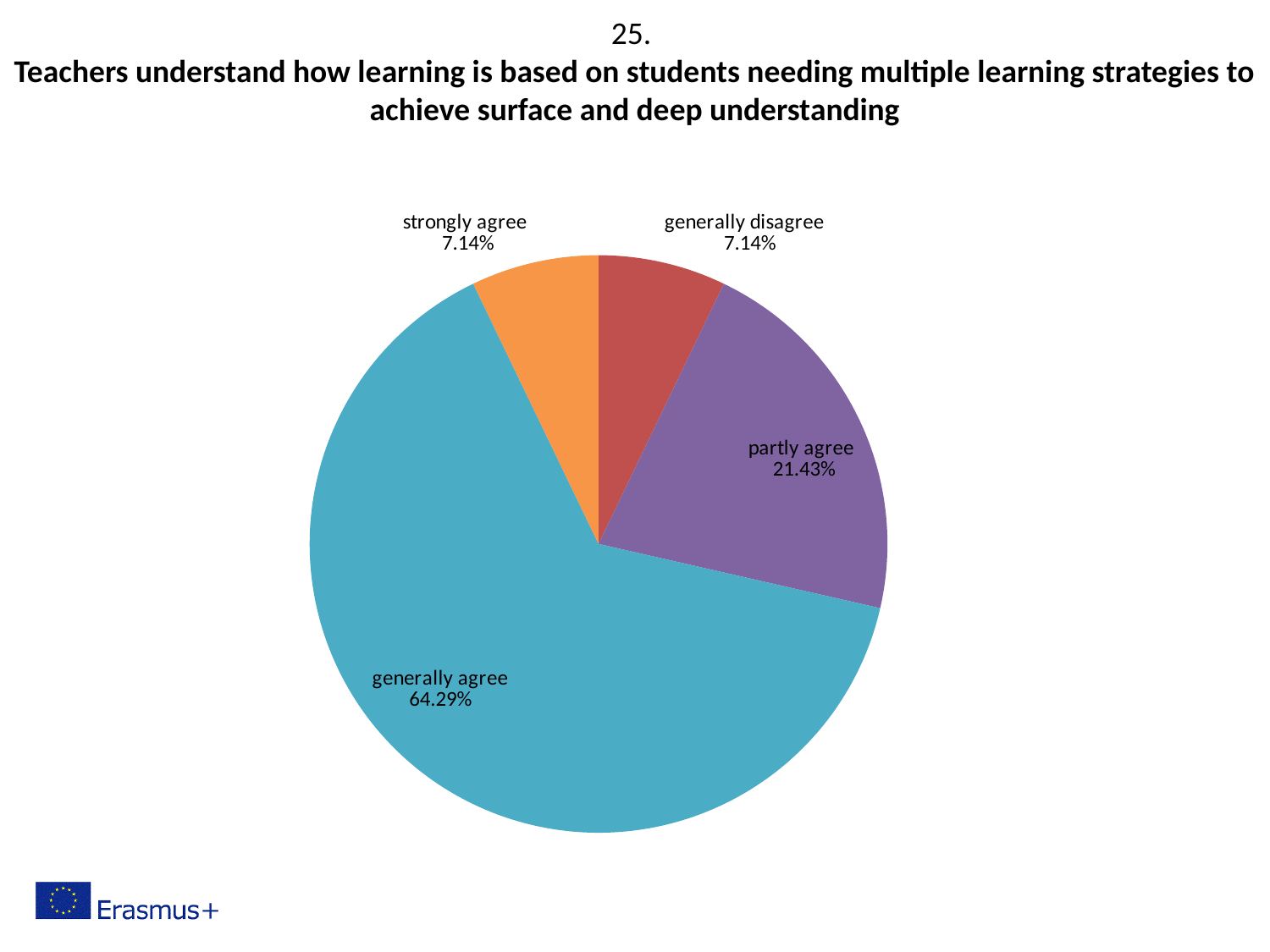
What share of the pie is labelled "strongly agree"? 7.14% Which is larger, the "partly agree" slice or the "strongly agree" slice? partly agree What is the difference between the "generally agree" share and the "partly agree" share? 42.86% What number appears above the chart title on the slide? 25. What share of the pie is labelled "generally agree"? 64.29% Which category has the largest slice of the pie? generally agree What is the combined share of "generally agree" and "strongly agree"? 71.43% What kind of chart is shown on the slide? pie chart What share of the pie is labelled "generally disagree"? 7.14% How many slices does the pie chart have? 4 What colour is the "generally agree" slice? teal blue